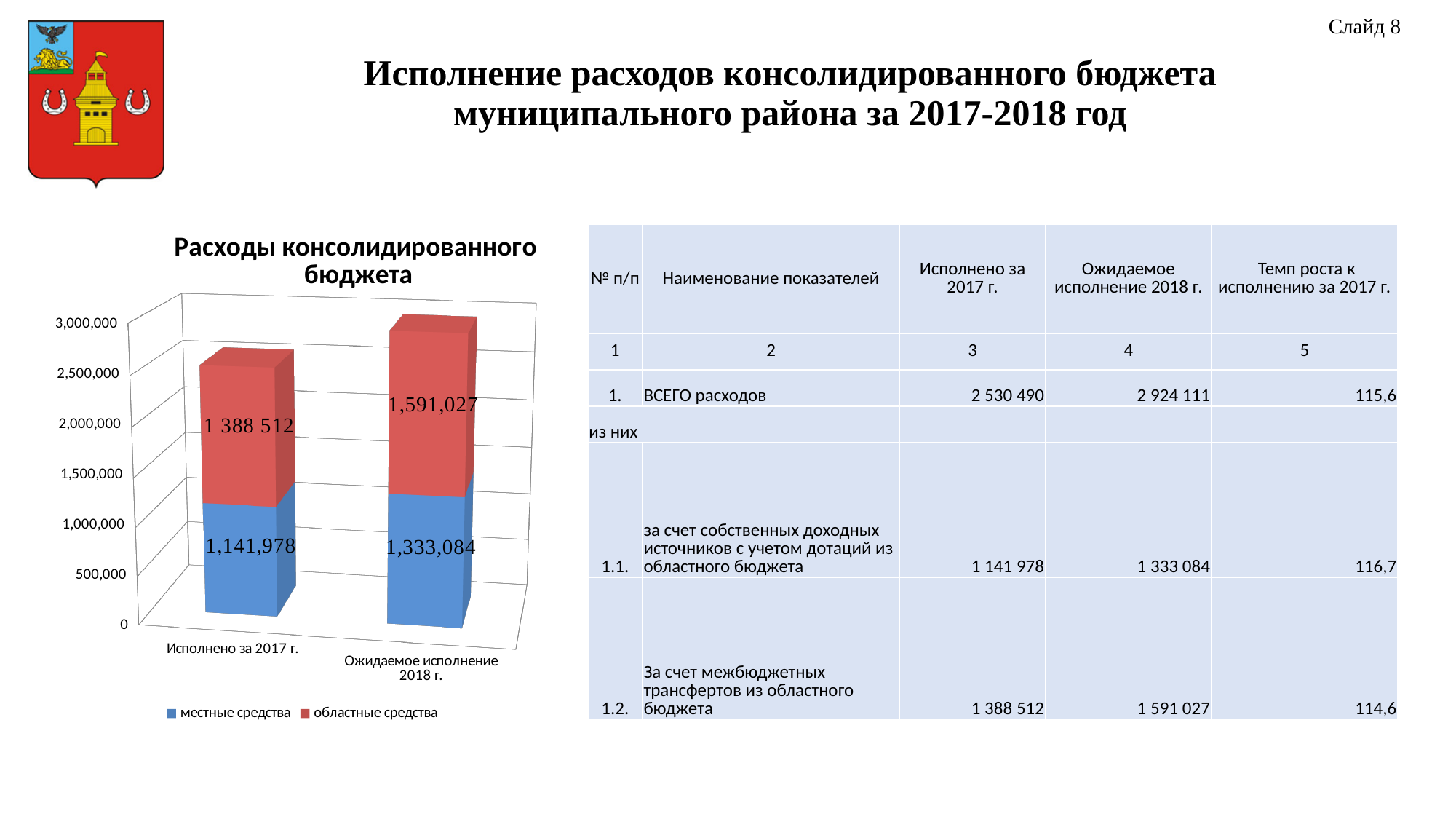
What is the value of местные средства for Исполнено за 2017 г.? 1,141,978 What is the total of the stacked bar for Ожидаемое исполнение 2018 г.? 2,924,111 How many series does the chart legend list? 2 Which is larger for Исполнено за 2017 г.: местные средства or областные средства? областные средства What is the value of областные средства for Ожидаемое исполнение 2018 г.? 1,591,027 What is the total of the stacked bar for Исполнено за 2017 г.? 2,530,490 By how much does областные средства for Ожидаемое исполнение 2018 г. exceed областные средства for Исполнено за 2017 г.? 202,515 Which colour represents областные средства in the chart? Red What is the value of областные средства for Исполнено за 2017 г.? 1 388 512 What is the value of местные средства for Ожидаемое исполнение 2018 г.? 1,333,084 What type of chart is shown on the slide? Stacked bar chart How many categories are shown on the x axis of the chart? 2